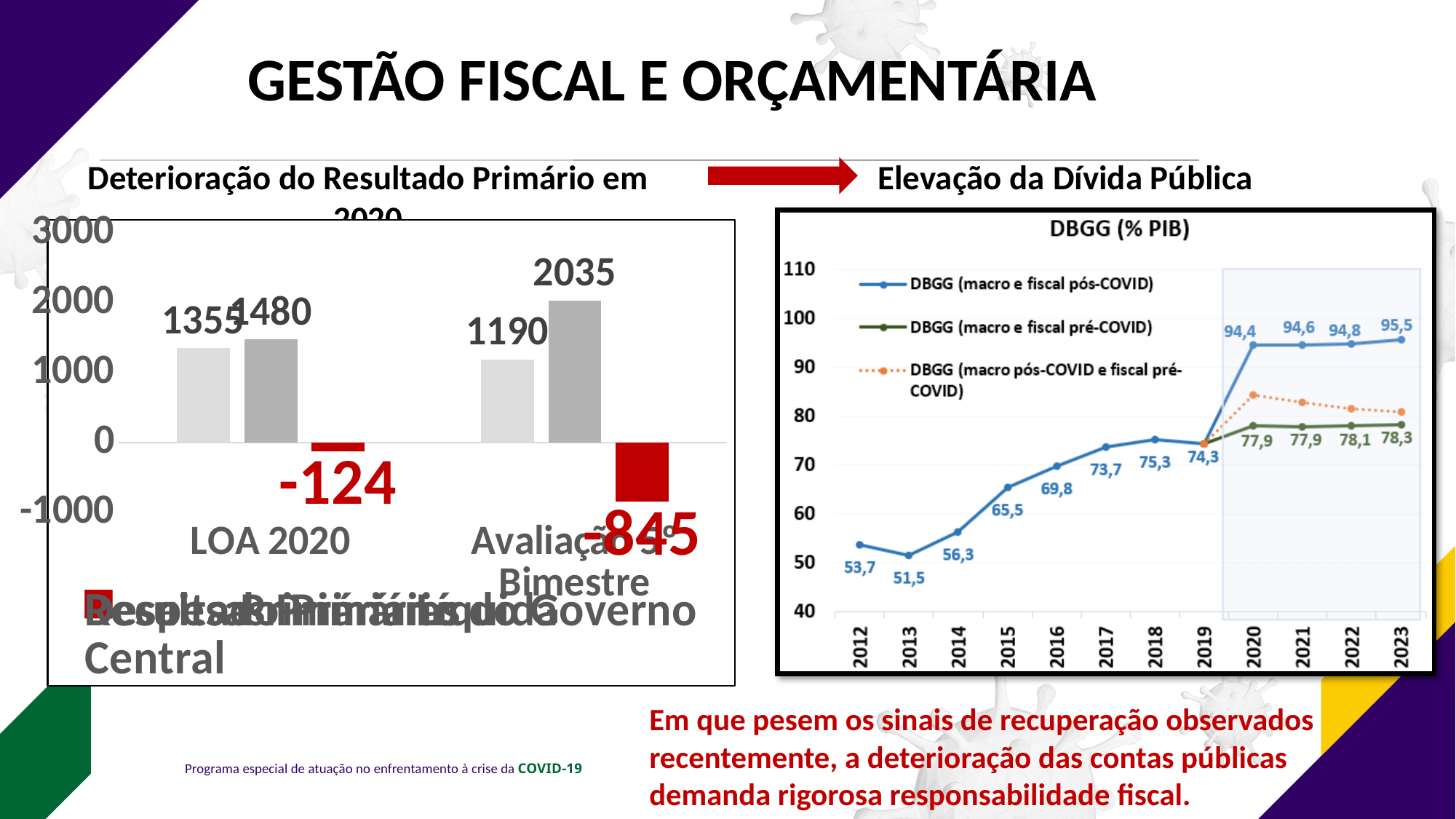
In the DBGG (% PIB) chart, what is the difference in 2020 between DBGG (macro e fiscal pós-COVID) and DBGG (macro e fiscal pré-COVID)? 16,5 In the DBGG (% PIB) chart, what is the value of DBGG (macro e fiscal pós-COVID) in 2023? 95,5 What kind of chart is the DBGG (% PIB) chart on the right? line chart How many categories are shown on the x axis of the bar chart on the left? 2 In the DBGG (% PIB) chart, which year has the lowest DBGG value? 2013 In the bar chart on the left, what is the difference between the dark grey bar for Avaliação 3º Bimestre and the dark grey bar for LOA 2020? 555 In the DBGG (% PIB) chart, what is the DBGG value in 2013? 51,5 In the DBGG (% PIB) chart, does the DBGG value rise or fall from 2013 to 2018? rise How many series does the legend of the DBGG (% PIB) chart list? 3 In the bar chart on the left, what is the value of the red bar for Avaliação 3º Bimestre? -845 In the bar chart on the left, what is the value of the dark grey bar for LOA 2020? 1480 In the DBGG (% PIB) chart, is the value of the orange dotted series in 2020 greater or less than 80? greater